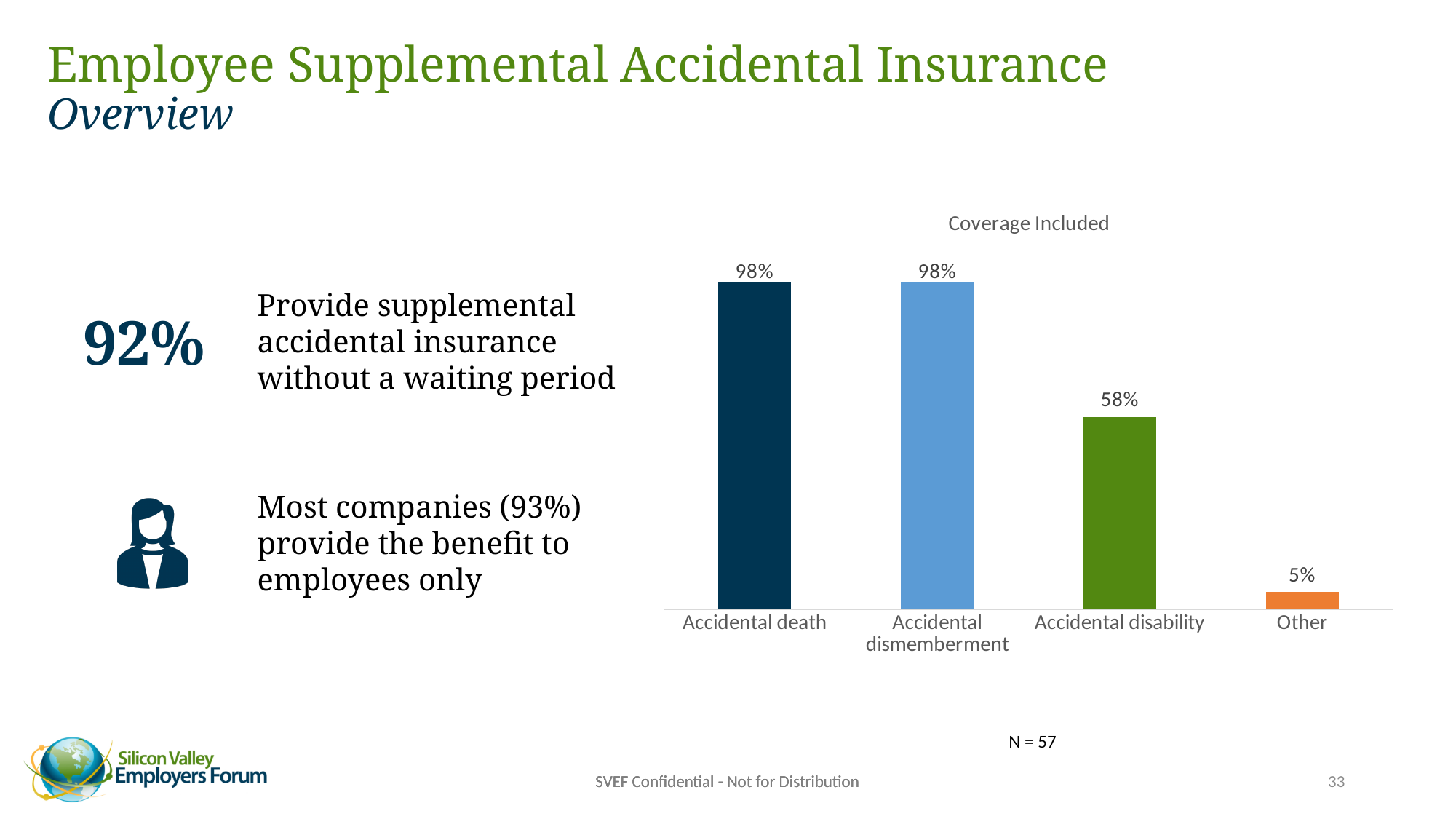
Which category has the lowest value in the Coverage Included chart? Other Which is larger, the value for Accidental disability or the value for Other? Accidental disability What is the difference between the values for Accidental death and Accidental disability? 40% What is the value for Other in the Coverage Included chart? 5% How many categories are shown in the Coverage Included chart? 4 What is the title of the chart on the slide? Coverage Included What is the value for Accidental death in the Coverage Included chart? 98% What is the value for Accidental dismemberment in the Coverage Included chart? 98% What is the difference between the values for Accidental disability and Other? 53% Which is larger, the value for Accidental dismemberment or the value for Accidental disability? Accidental dismemberment What is the value for Accidental disability in the Coverage Included chart? 58% What kind of chart is shown on the slide? Bar chart